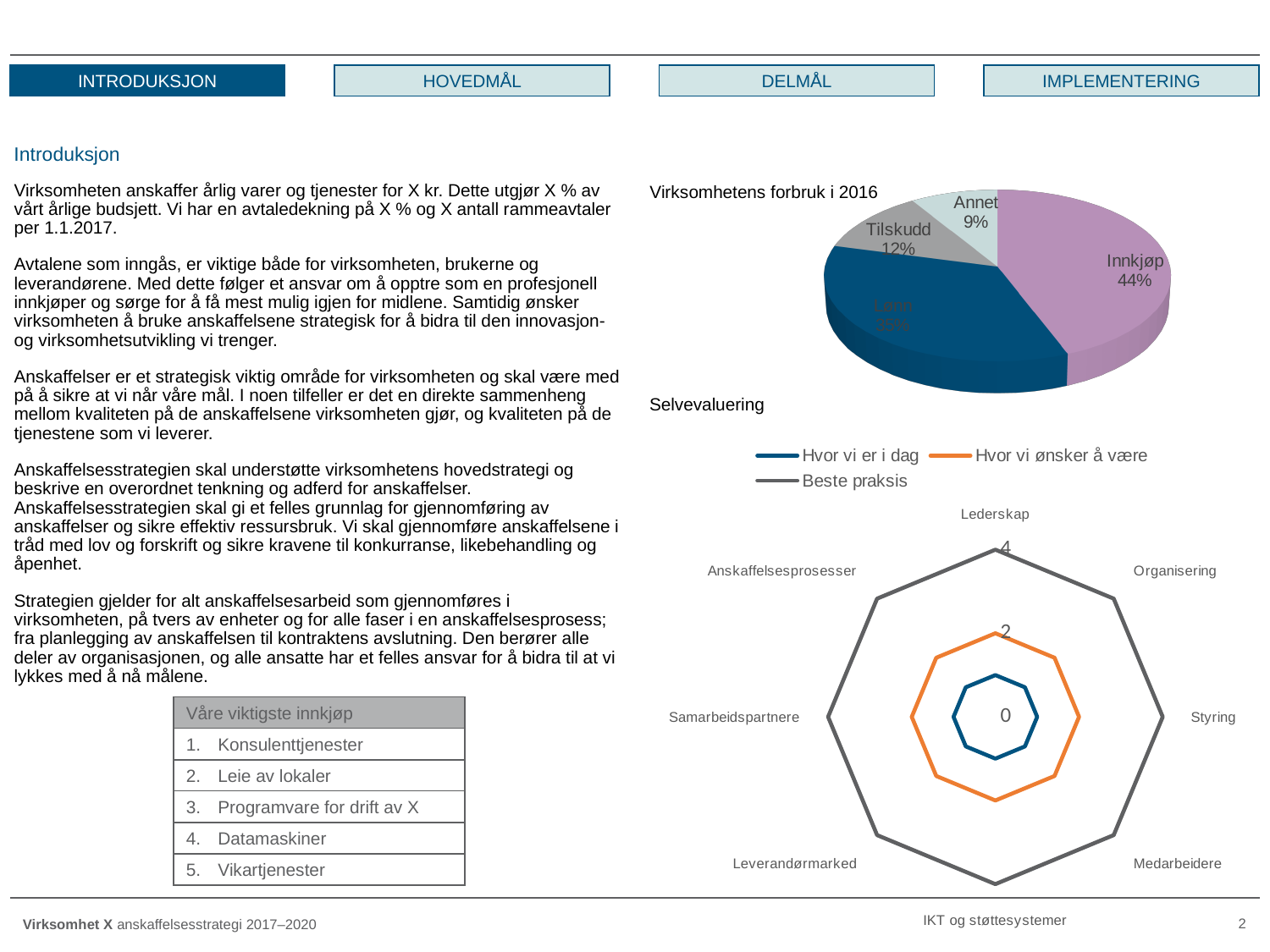
In the pie chart 'Virksomhetens forbruk i 2016', what is the difference in percentage points between Tilskudd and Annet? 3 percentage points In the 'Selvevaluering' chart, is the value of 'Hvor vi er i dag' for Styring greater or less than 2? less In the pie chart 'Virksomhetens forbruk i 2016', what share does Annet have? 9% In the pie chart 'Virksomhetens forbruk i 2016', which is larger, Tilskudd or Annet? Tilskudd In the pie chart 'Virksomhetens forbruk i 2016', what share does Tilskudd have? 12% In the pie chart 'Virksomhetens forbruk i 2016', what share does Innkjøp have? 44% In the pie chart 'Virksomhetens forbruk i 2016', which category has the largest slice? Innkjøp In the 'Selvevaluering' chart, what value does the 'Hvor vi ønsker å være' series have for Lederskap? 2 How many series does the legend of the 'Selvevaluering' chart list? 3 What kind of chart is 'Virksomhetens forbruk i 2016'? Pie chart In the pie chart 'Virksomhetens forbruk i 2016', which category has the smallest slice? Annet In the 'Selvevaluering' chart, what value does the 'Beste praksis' series have for Lederskap? 4